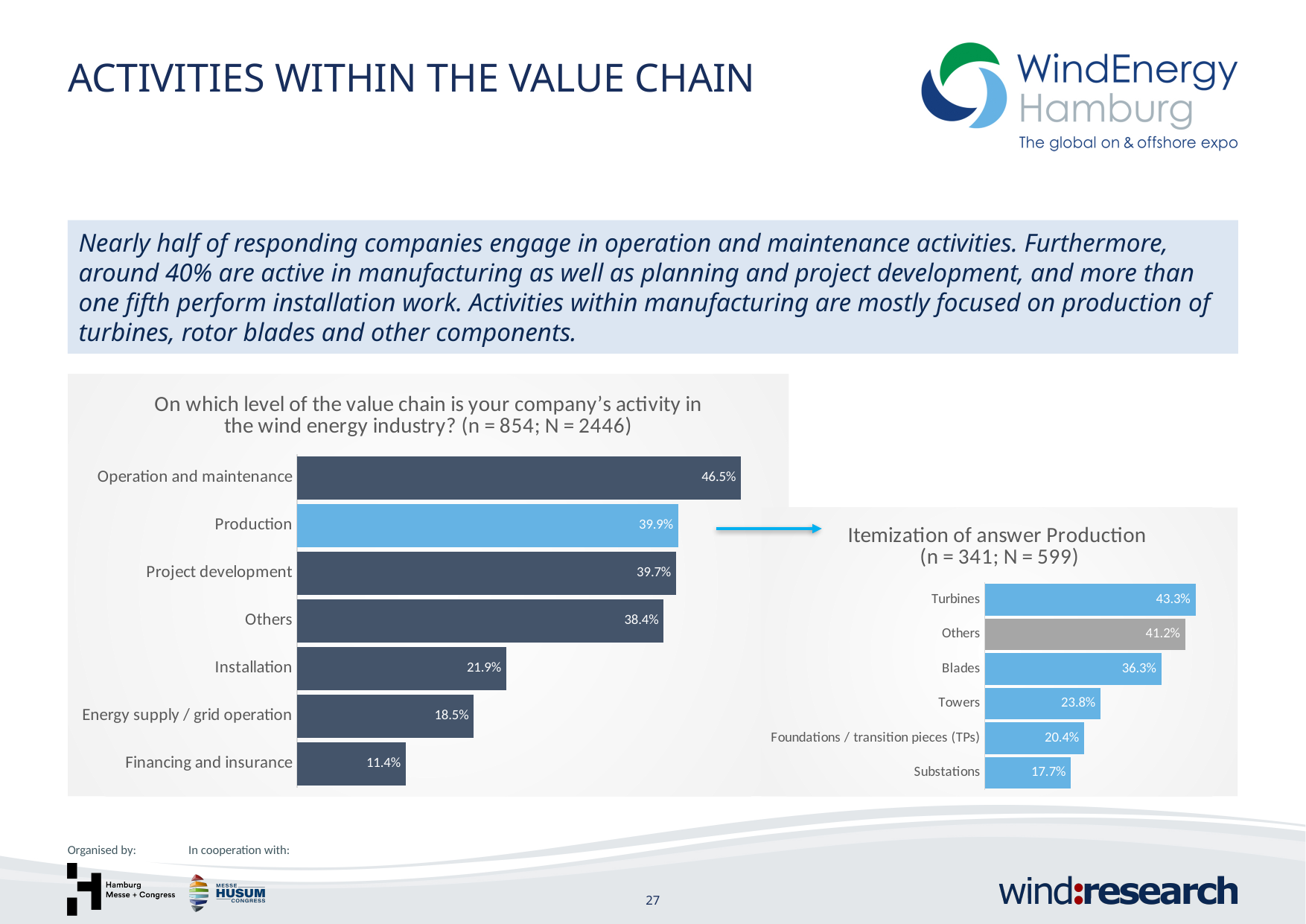
In the chart 'Itemization of answer Production', what is the value for Foundations / transition pieces (TPs)? 20.4% In the left chart, what is the difference between Operation and maintenance and Production? 6.6% In the left chart, which category has the lowest value? Financing and insurance In the chart 'Itemization of answer Production', which category has the lowest value? Substations In the chart 'Itemization of answer Production', what is the difference between Turbines and Blades? 7.0% In the left chart, which is larger: Installation or Energy supply / grid operation? Installation In the left chart, what percentage is shown for Financing and insurance? 11.4% What type of chart is the 'Itemization of answer Production' chart? Bar chart How many categories are shown in the left chart? 7 In the chart 'Itemization of answer Production', what is the value for Towers? 23.8% In the left chart, which category has the highest value? Operation and maintenance In the chart 'On which level of the value chain is your company's activity in the wind energy industry?', what is the value for Installation? 21.9%